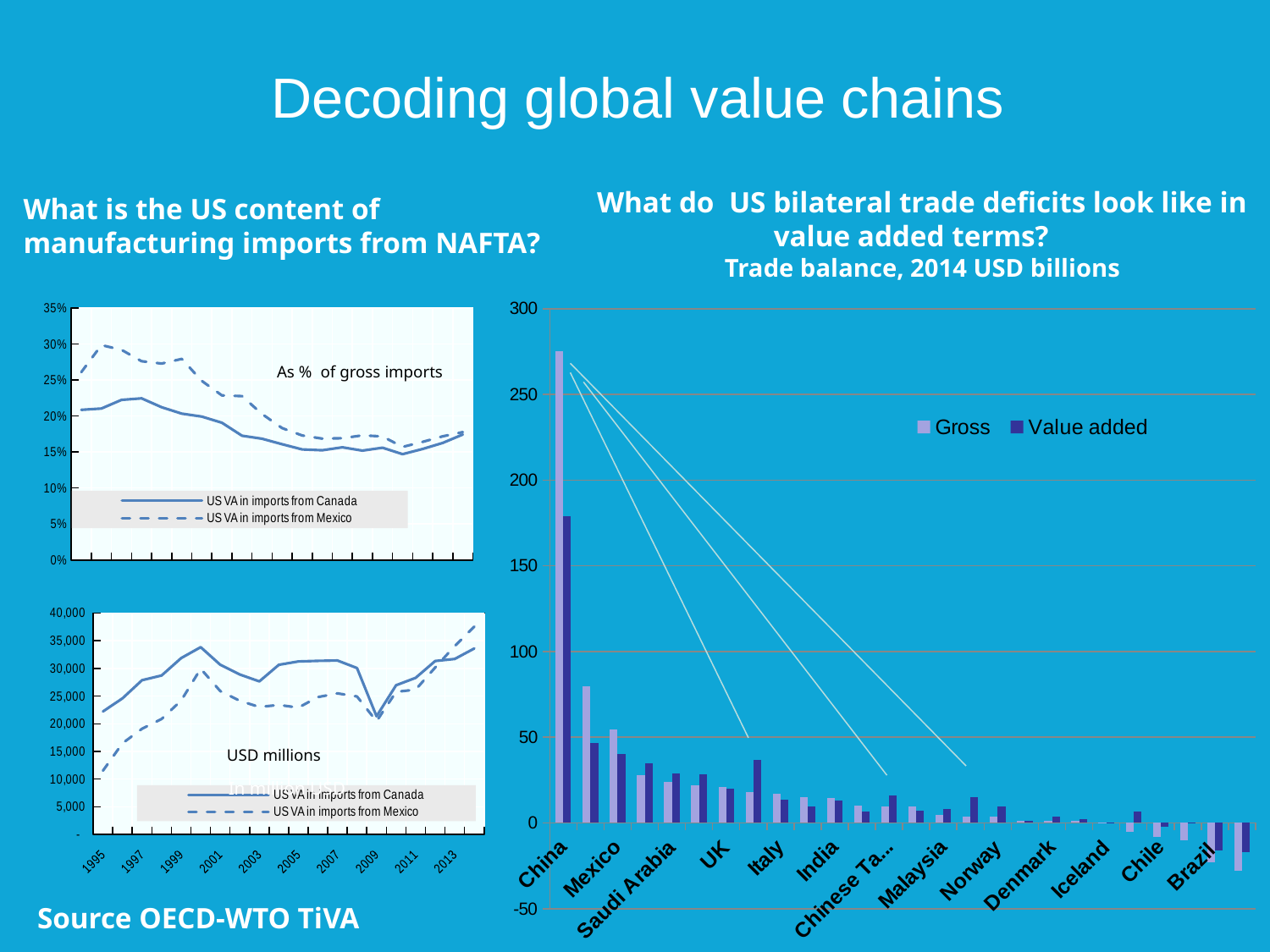
In the 'Trade balance, 2014 USD billions' chart, which is larger for China: Gross or Value added? Gross In the 'Trade balance, 2014 USD billions' chart, how many series does the legend list? 2 In the 'Trade balance, 2014 USD billions' chart, which category has the highest Gross value? China In the 'Trade balance, 2014 USD billions' chart, is the Gross value for China greater or less than 250? greater What kind of chart is the top-left chart labelled 'As % of gross imports'? line chart In the bottom-left chart 'USD millions', which series is higher in 2000: 'US VA in imports from Canada' or 'US VA in imports from Mexico'? US VA in imports from Canada In the top-left chart 'As % of gross imports', does the 'US VA in imports from Canada' series overall rise or fall from left to right? fall In the bottom-left chart 'USD millions', is the value for 'US VA in imports from Canada' in 2009 greater or less than 25,000? less In the 'Trade balance, 2014 USD billions' chart, what are the two legend entries? Gross and Value added In the 'Trade balance, 2014 USD billions' chart, is the Value added value for China greater or less than 150? greater What kind of chart is the right-hand chart titled 'Trade balance, 2014 USD billions'? bar chart